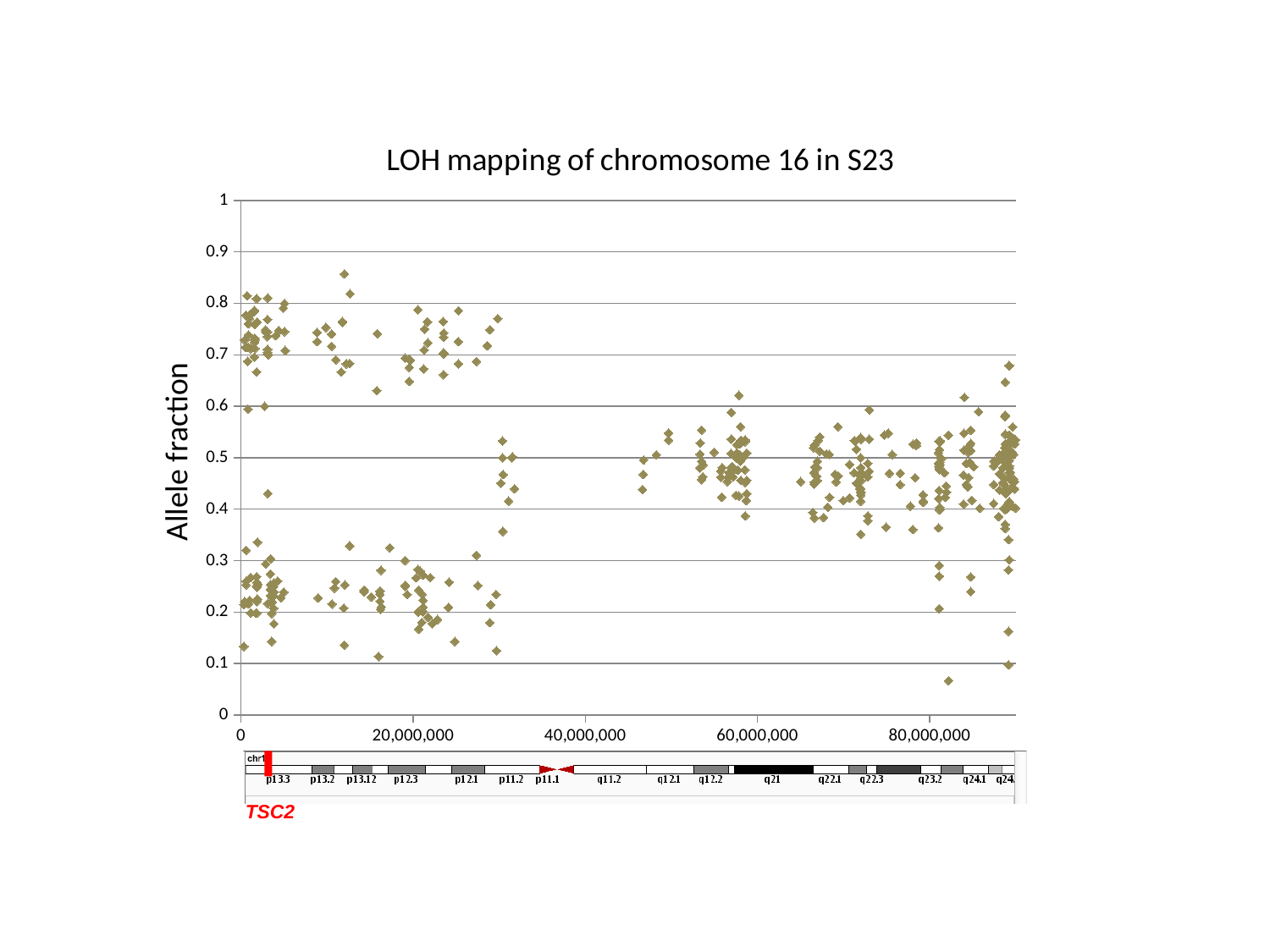
What is the largest value shown on the vertical axis? 1 What is the title of the chart? LOH mapping of chromosome 16 in S23 What kind of chart is shown on the slide? scatter plot Is the point plotted near 0.85 on the y axis located at an x position greater or less than 20,000,000? less Is the highest plotted point on the chart greater or less than 0.9? less What is the largest tick label shown on the horizontal axis? 80,000,000 Are the points plotted between 60,000,000 and 80,000,000 on the x axis greater or less than 0.7? less